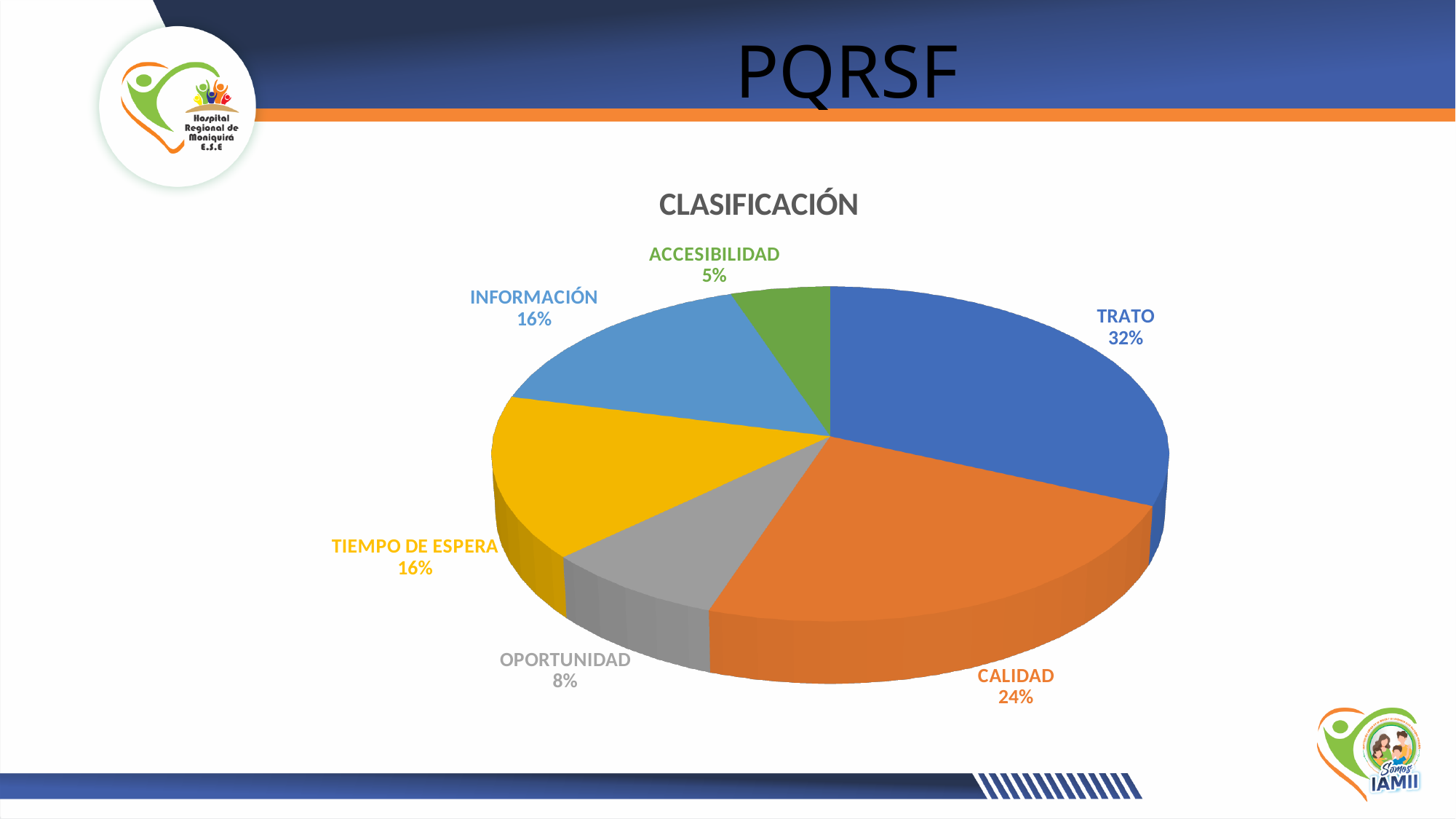
What type of chart is shown on the slide? Pie chart What percentage does the CALIDAD slice represent? 24% What percentage does the ACCESIBILIDAD slice represent? 5% Which is larger, the share for INFORMACIÓN or the share for OPORTUNIDAD? INFORMACIÓN How many categories are shown in the pie chart? 6 What percentage does the TRATO slice represent? 32% What is the difference in percentage points between TRATO and CALIDAD? 8 What percentage does the OPORTUNIDAD slice represent? 8% What colour is the CALIDAD slice? Orange What is the title of the chart? CLASIFICACIÓN Which category has the largest share of the pie? TRATO Which category has the smallest share of the pie? ACCESIBILIDAD